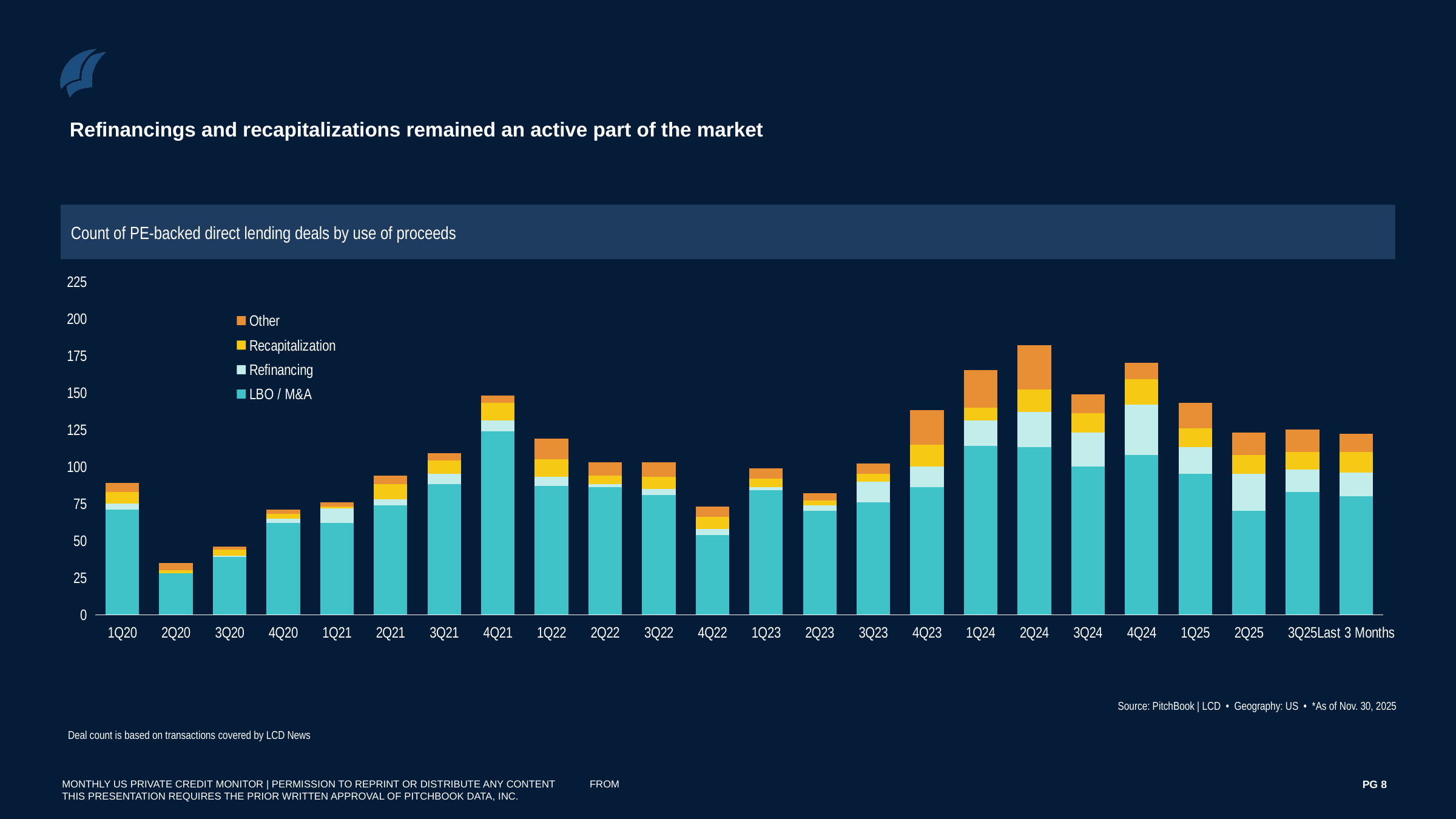
Which period has the lowest total count of deals? 2Q20 Is the total deal count for 2Q20 greater or less than 50? less Which series is shown at the bottom of each stacked bar? LBO / M&A Which period has a larger total deal count, 3Q21 or 4Q21? 4Q21 Which period has the highest total count of deals? 2Q24 How many series does the legend list? 4 Does the total deal count rise or fall from 1Q20 to 2Q20? Fall Is the total deal count for 1Q24 greater or less than 150? greater What kind of chart is shown on the slide? Stacked bar chart Is the total deal count for 4Q22 greater or less than 100? less How many quarterly/period categories are shown on the x axis? 24